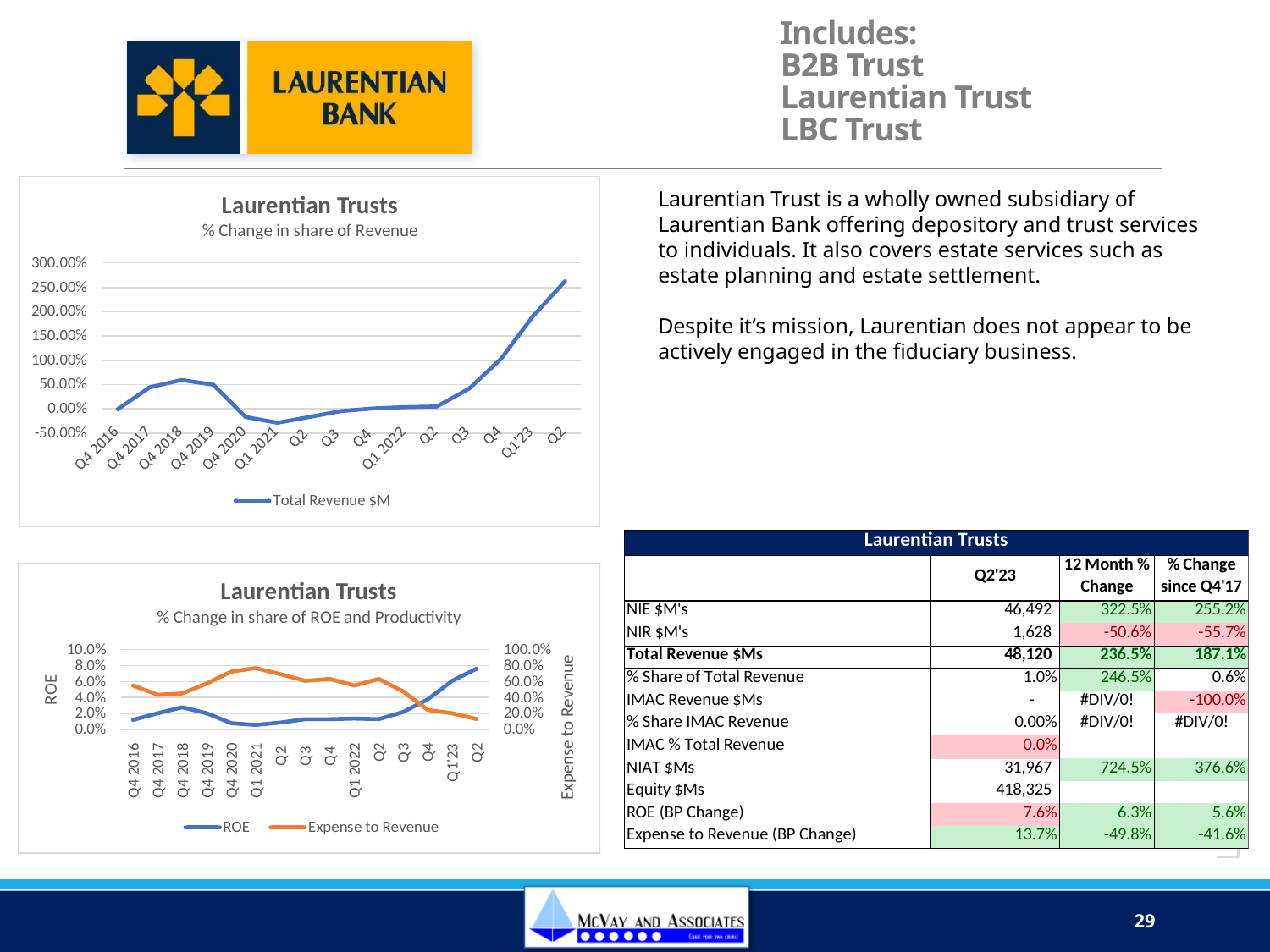
In the bottom-left chart (% Change in share of ROE and Productivity), at which x-axis category is the Expense to Revenue value highest? Q1 2021 In the top-left chart (% Change in share of Revenue), is the Total Revenue $M value at Q4 2020 greater or less than 0.00%? less In the top-left chart (% Change in share of Revenue), is the Total Revenue $M value at the final Q2 point greater or less than 200.00%? greater In the bottom-left chart (% Change in share of ROE and Productivity), is the Expense to Revenue value at Q1 2021 greater or less than 60.0%? greater In the bottom-left chart (% Change in share of ROE and Productivity), which series is plotted in orange? Expense to Revenue In the top-left chart (% Change in share of Revenue), does the Total Revenue $M line rise or fall from Q3 2022 to the final Q2 point? rise In the top-left chart (% Change in share of Revenue), how many points are plotted along the x axis? 15 In the bottom-left chart (% Change in share of ROE and Productivity), how many series does the legend list? 2 In the top-left chart (% Change in share of Revenue), what is the name of the series shown in the legend? Total Revenue $M What kind of chart is the top-left chart titled 'Laurentian Trusts – % Change in share of Revenue'? line chart In the top-left chart (% Change in share of Revenue), at which x-axis category is the Total Revenue $M value highest? Q2 (the last point) In the top-left chart (% Change in share of Revenue), how many series does the legend list? 1